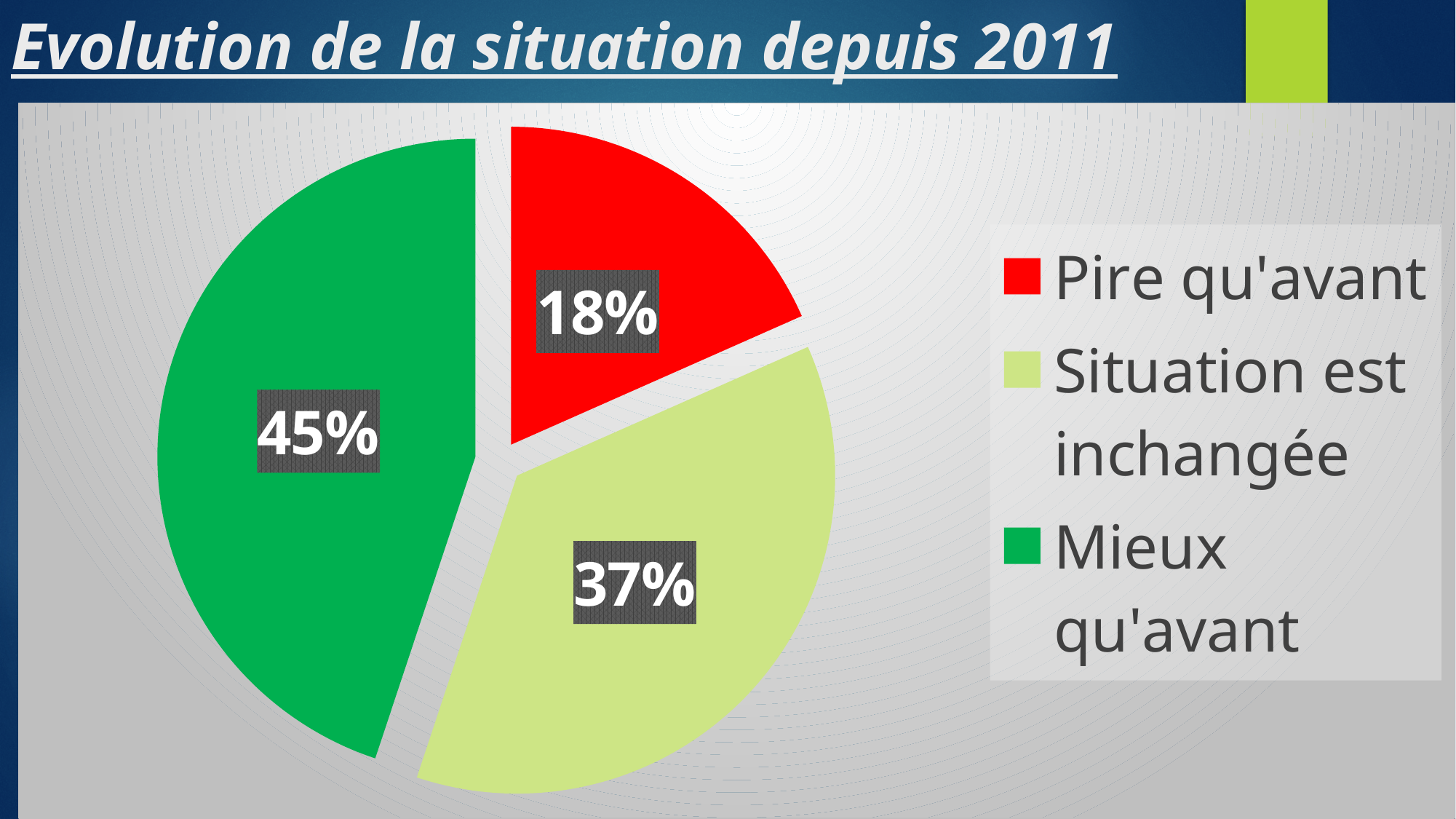
What percentage is shown for "Mieux qu'avant"? 45% What is the difference in percentage points between "Mieux qu'avant" and "Situation est inchangée"? 8 What colour is the slice for "Pire qu'avant"? Red What is the difference in percentage points between "Mieux qu'avant" and "Pire qu'avant"? 27 How many slices does the pie chart have? 3 What percentage is shown for "Situation est inchangée"? 37% Which category has the smallest share of the pie? Pire qu'avant Which is larger: the share for "Situation est inchangée" or the share for "Pire qu'avant"? Situation est inchangée What type of chart is shown on the slide? Pie chart What percentage is shown for "Pire qu'avant"? 18% What is the title of the slide containing the chart? Evolution de la situation depuis 2011 Which category has the largest share of the pie? Mieux qu'avant